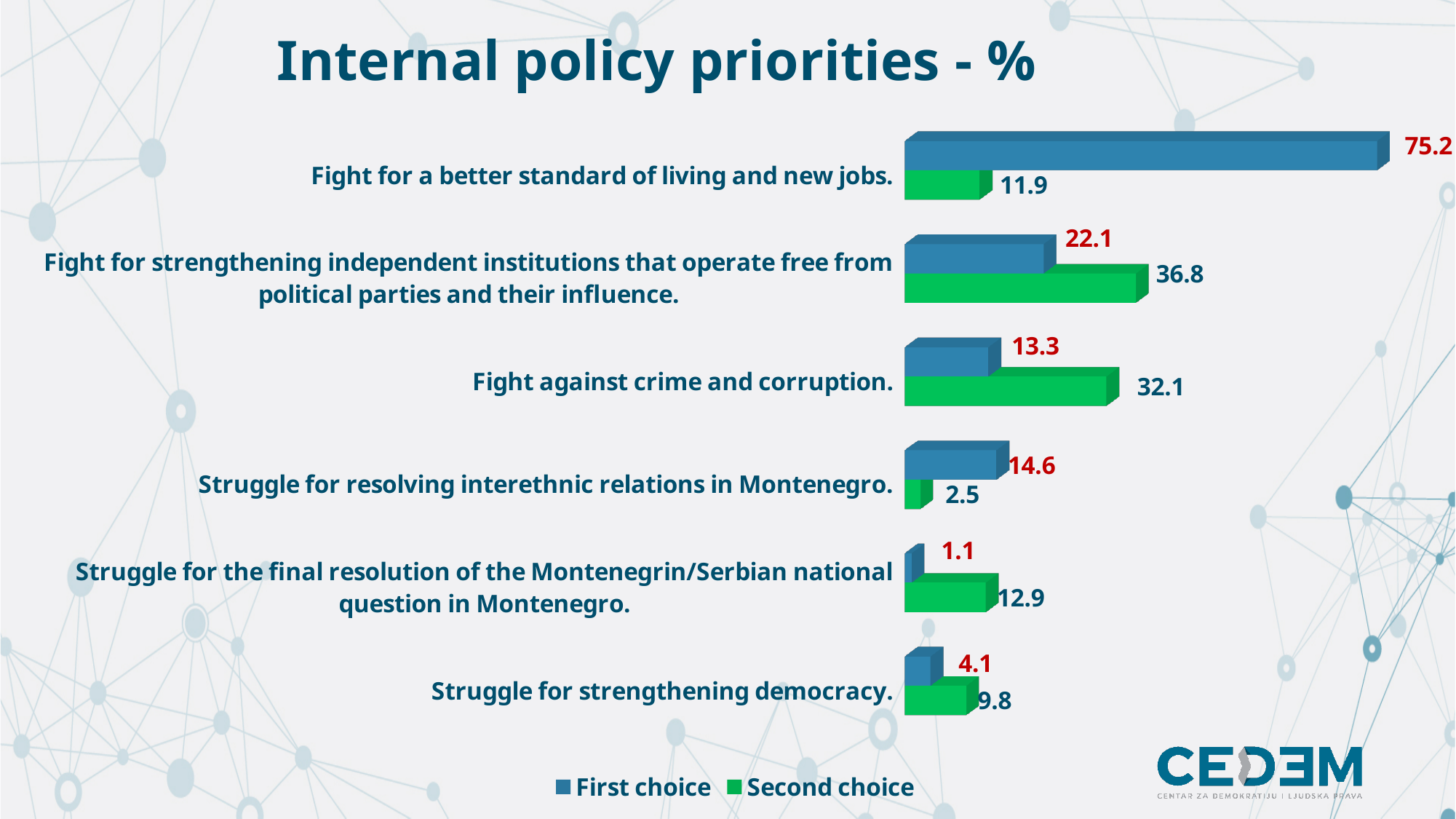
Which category has the highest Second choice value? Fight for strengthening independent institutions that operate free from political parties and their influence. What is the Second choice value for "Fight against crime and corruption."? 32.1 Which category has the lowest First choice value? Struggle for the final resolution of the Montenegrin/Serbian national question in Montenegro. What is the title of the chart? Internal policy priorities - % What is the First choice value for "Fight for a better standard of living and new jobs."? 75.2 How many categories are shown in the chart? 6 Which colour represents the Second choice series? Green What is the First choice value for "Struggle for the final resolution of the Montenegrin/Serbian national question in Montenegro."? 1.1 What kind of chart is shown on the slide? Bar chart Which is larger for "Struggle for strengthening democracy.": the First choice value or the Second choice value? Second choice What is the difference between the First choice and Second choice values for "Fight for a better standard of living and new jobs."? 63.3 How many series does the legend list? 2